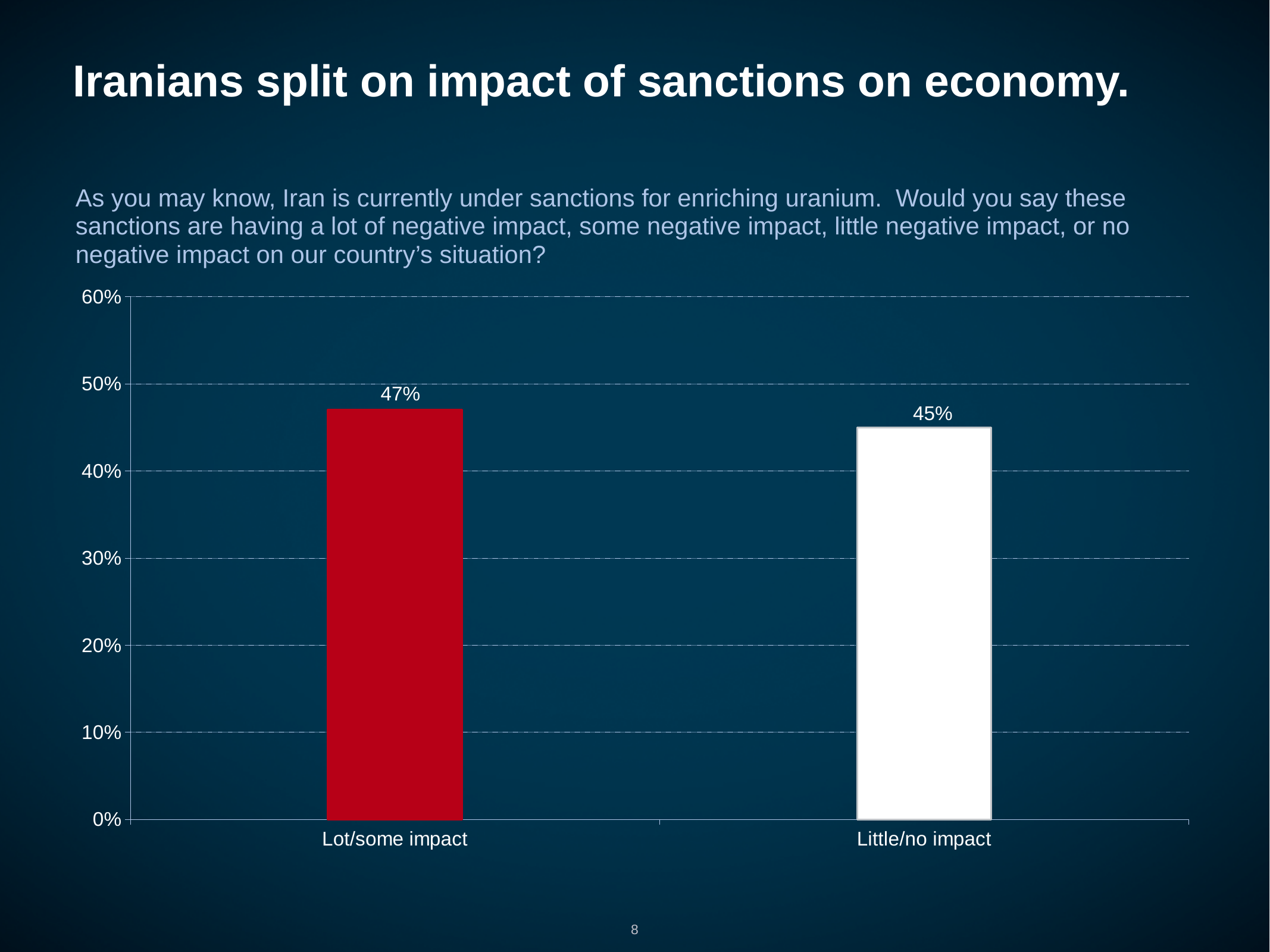
Which category has the highest value? Lot/some impact What kind of chart is shown on the slide? bar chart What is the value for Lot/some impact? 47% Which category has the lowest value? Little/no impact Is the value for Lot/some impact greater or less than 50%? less What is the highest value shown on the vertical axis? 60% What is the value for Little/no impact? 45% What is the difference between the values for Lot/some impact and Little/no impact? 2% Is the value for Little/no impact greater or less than 40%? greater How many categories are shown in the chart? 2 What colour is the bar for Lot/some impact? red